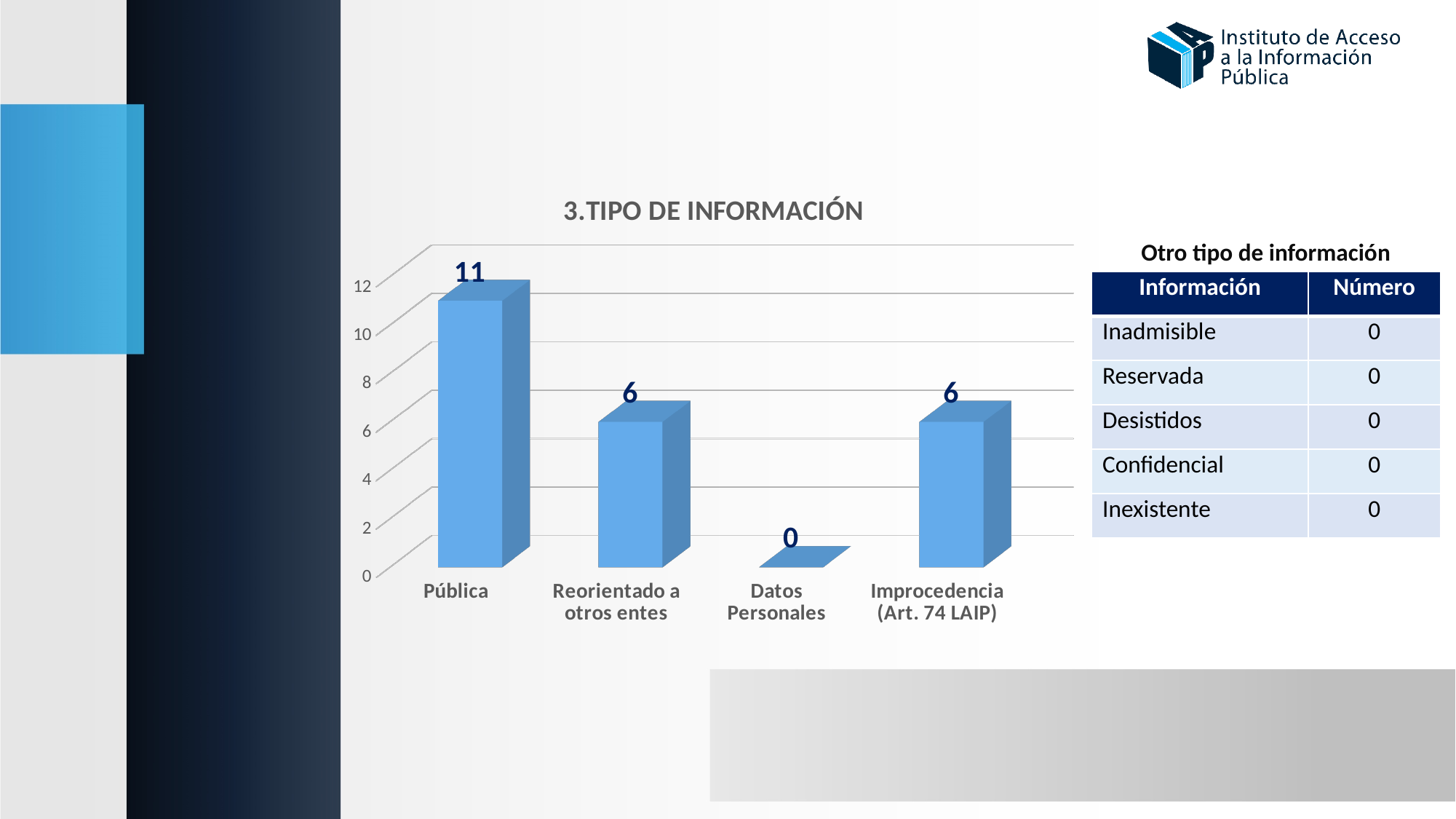
Which category has the lowest value? Datos Personales Is the value for Pública greater or less than 10? greater What is the difference between the values for Pública and Reorientado a otros entes? 5 Which is larger, the value for Pública or the value for Improcedencia (Art. 74 LAIP)? Pública What is the value for Reorientado a otros entes? 6 What is the value for Improcedencia (Art. 74 LAIP)? 6 What kind of chart is shown? bar chart What is the title of the chart? 3.TIPO DE INFORMACIÓN Which category has the highest value? Pública How many categories are shown on the x axis? 4 What is the value for Datos Personales? 0 What is the value for Pública? 11